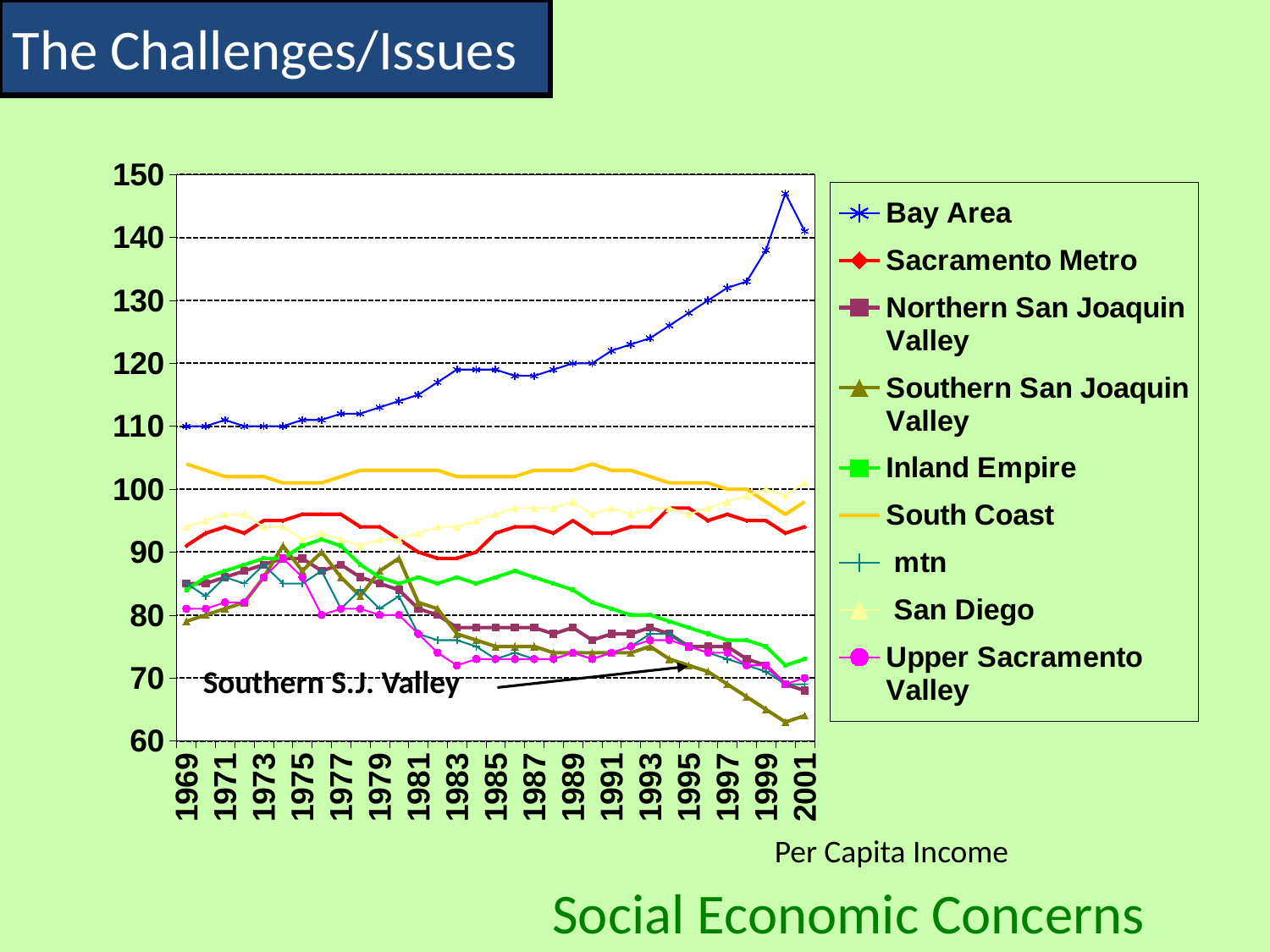
Does the Bay Area series rise or fall overall from 1969 to 2001? rise In 1995, which is larger: Sacramento Metro or Inland Empire? Sacramento Metro Which series has the lowest value in 2001? Southern San Joaquin Valley Is the value for Bay Area in 2000 greater or less than 140? greater Is the value for South Coast in 1969 greater or less than 100? greater What kind of chart is shown on the slide? line chart What is the first year shown on the x axis? 1969 In 2001, which is larger: Bay Area or South Coast? Bay Area How many series does the legend list? 9 Is the value for Southern San Joaquin Valley in 2001 greater or less than 70? less Does the Southern San Joaquin Valley series rise or fall overall from 1975 to 2001? fall Which series has the highest value in 2001? Bay Area